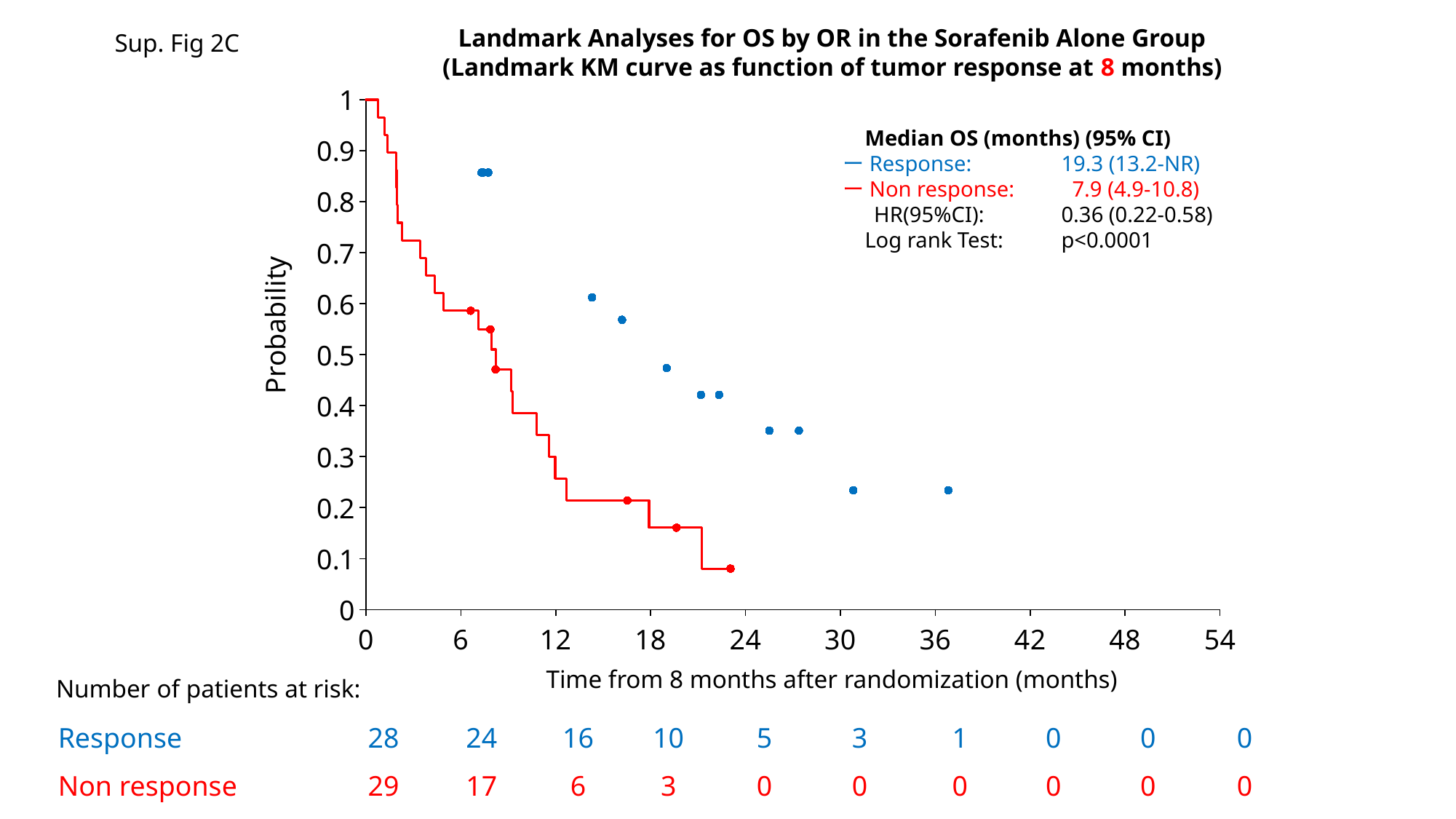
What is the log rank test p-value shown on the chart? p<0.0001 How many groups does the legend list? 2 Is the Non response survival probability at 12 months greater or less than 0.5? less What is the median OS (95% CI) for the Non response group? 7.9 (4.9-10.8) At 12 months, which group has more patients at risk, Response or Non response? Response What is the difference between the number of Non response and Response patients at risk at time 0? 1 How many Non response patients are at risk at 6 months? 17 How many Response patients are at risk at time 0? 28 What is the hazard ratio (95% CI) shown on the chart? 0.36 (0.22-0.58) What is the x-axis label of the chart? Time from 8 months after randomization (months) What is the median OS (95% CI) for the Response group? 19.3 (13.2-NR) How many Response patients are at risk at 12 months? 16